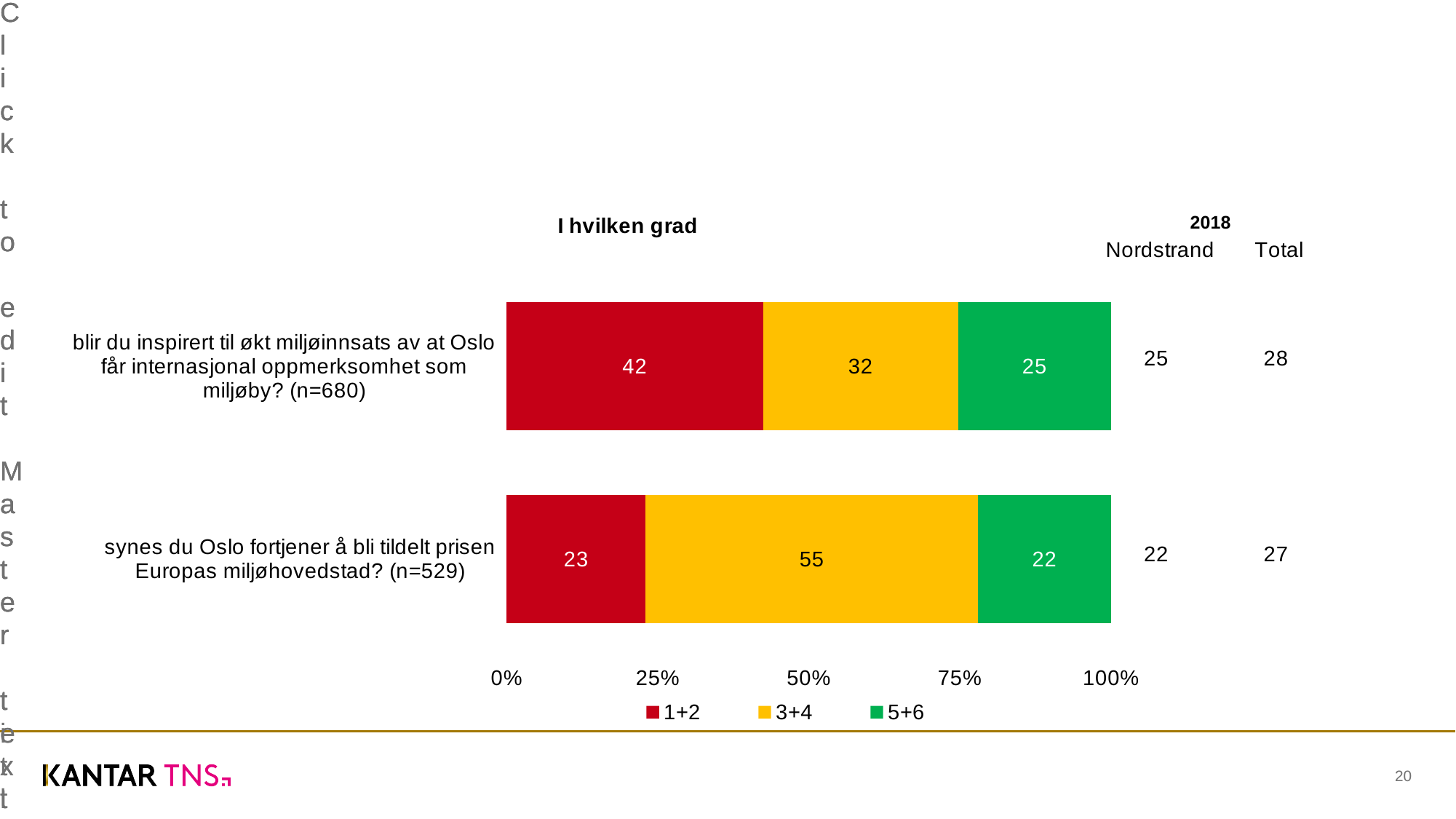
How many series does the legend list? 3 What is the difference between the 3+4 values of the two categories? 23 Which colour represents the 5+6 series in the legend? Green What kind of chart is shown on the slide? Stacked bar chart Is the 1+2 value larger for "blir du inspirert til økt miljøinnsats..." or for "synes du Oslo fortjener å bli tildelt prisen Europas miljøhovedstad?"? blir du inspirert til økt miljøinnsats av at Oslo får internasjonal oppmerksomhet som miljøby? (n=680) How many categories (questions) are plotted in the chart? 2 What is the value of the 5+6 segment for "synes du Oslo fortjener å bli tildelt prisen Europas miljøhovedstad? (n=529)"? 22 Which category has the lowest 3+4 value? blir du inspirert til økt miljøinnsats av at Oslo får internasjonal oppmerksomhet som miljøby? (n=680) Which category has the highest 1+2 value? blir du inspirert til økt miljøinnsats av at Oslo får internasjonal oppmerksomhet som miljøby? (n=680) What is the total of the stacked bar for "synes du Oslo fortjener å bli tildelt prisen Europas miljøhovedstad? (n=529)"? 100 What is the value of the 3+4 segment for "synes du Oslo fortjener å bli tildelt prisen Europas miljøhovedstad? (n=529)"? 55 What is the value of the 1+2 segment for "blir du inspirert til økt miljøinnsats av at Oslo får internasjonal oppmerksomhet som miljøby? (n=680)"? 42